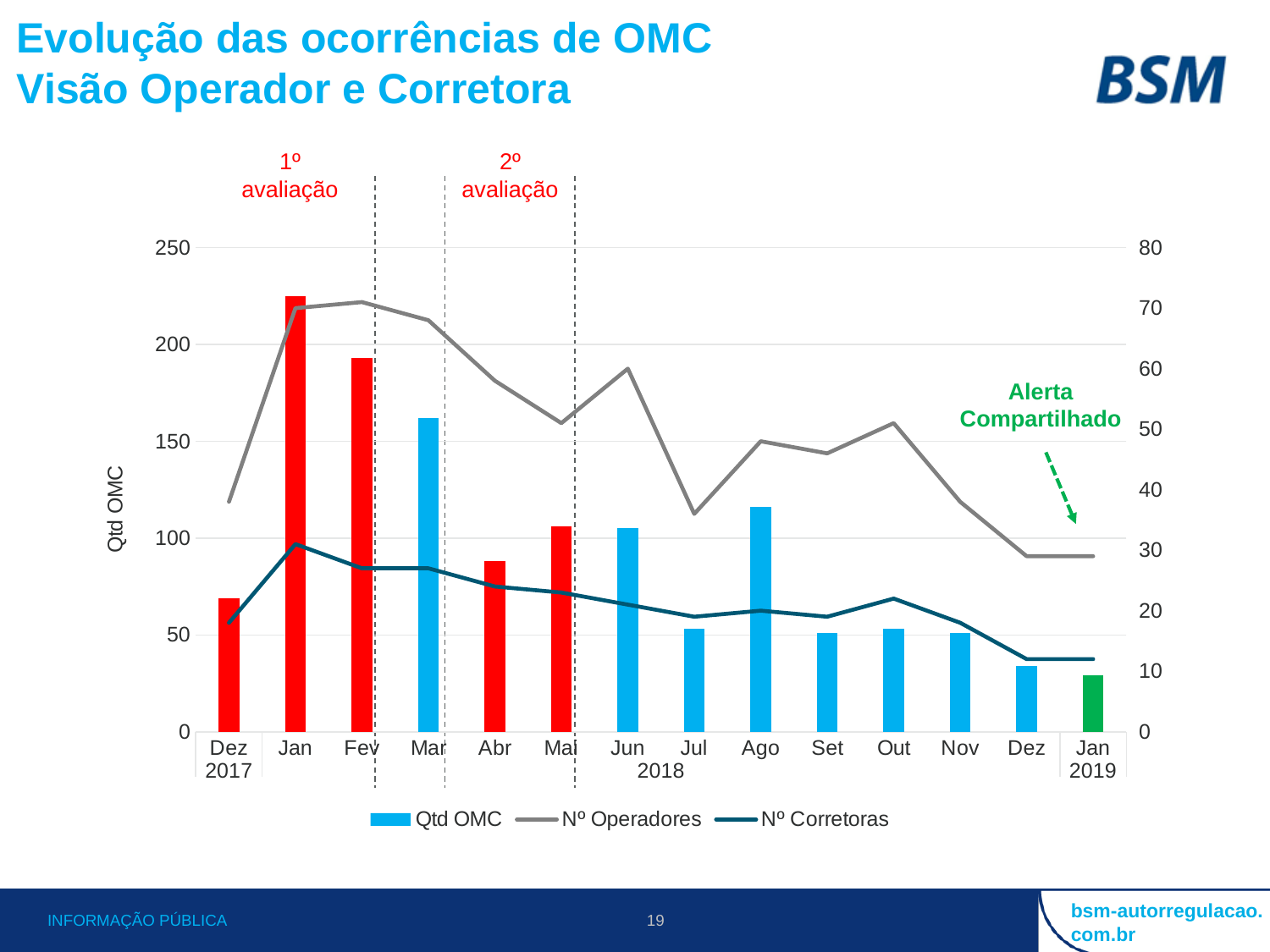
Which has the larger Qtd OMC bar, Fev 2018 or Mar 2018? Fev 2018 Does the Nº Operadores line rise or fall from Out 2018 to Dez 2018? Fall Which month has the highest Qtd OMC bar? Jan 2018 What is the title of the left vertical axis? Qtd OMC What kind of chart is this? Combined bar and line chart Which has the larger Qtd OMC bar, Jul 2018 or Ago 2018? Ago 2018 Is the Qtd OMC value for Jan 2018 greater or less than 200? greater Is the Qtd OMC value for Jul 2018 greater or less than 100? less How many months are shown on the x axis? 14 How many series does the legend list? 3 Is the Qtd OMC value for Fev 2018 greater or less than 150? greater